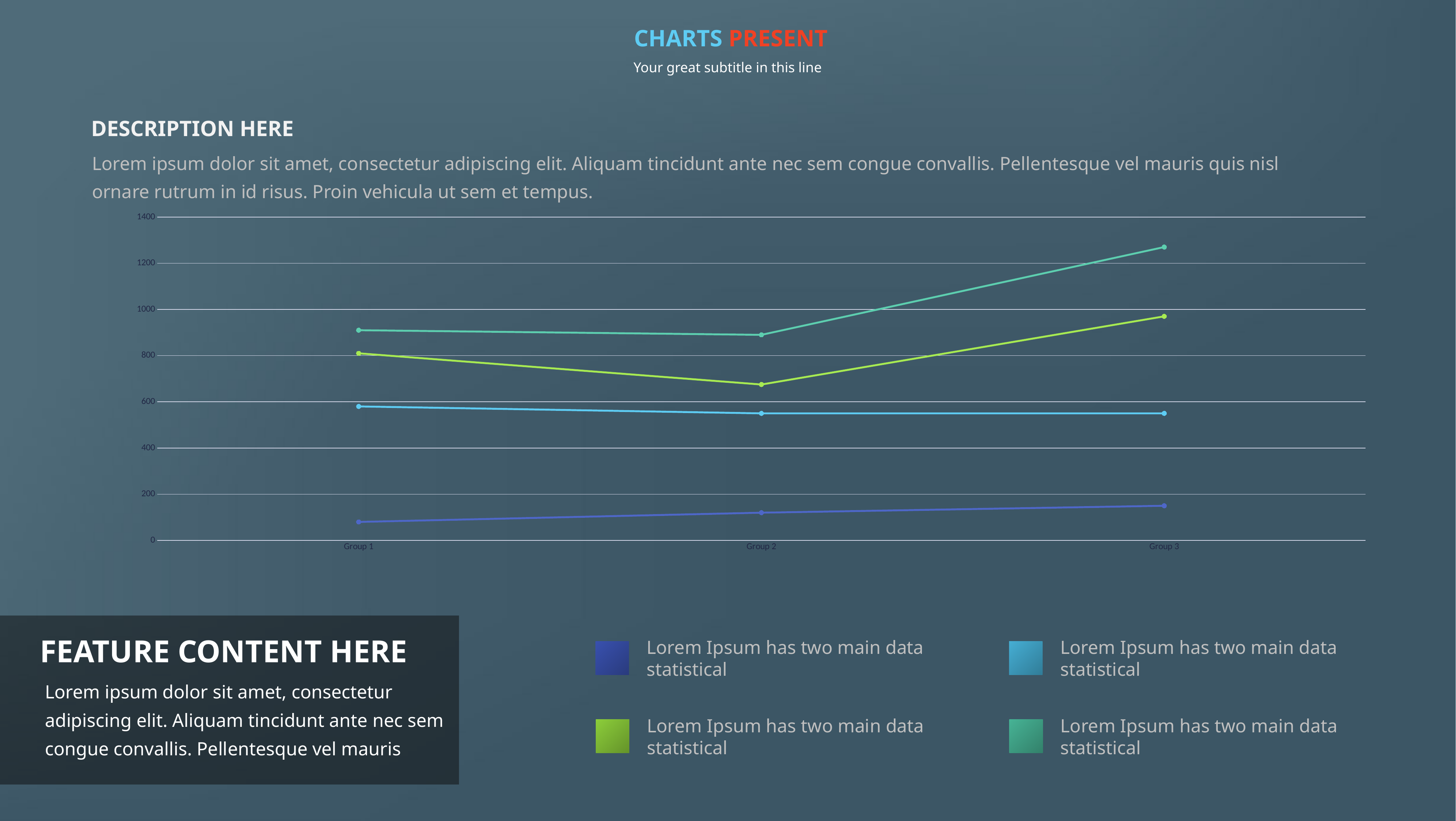
Does the dark blue line rise or fall from Group 1 to Group 3? rise How many series does the chart's legend list? 4 Is the value of the light blue line at Group 1 greater or less than 400? greater Which line has the highest value at Group 3? the teal line Is the value of the teal line at Group 3 greater or less than 1200? greater Is the value of the teal line at Group 1 greater or less than 1000? less At Group 2, which is larger: the green line or the light blue line? the green line Which line has the lowest value at Group 1? the dark blue line What kind of chart is shown on the slide? line chart How many categories are shown on the x axis of the chart? 3